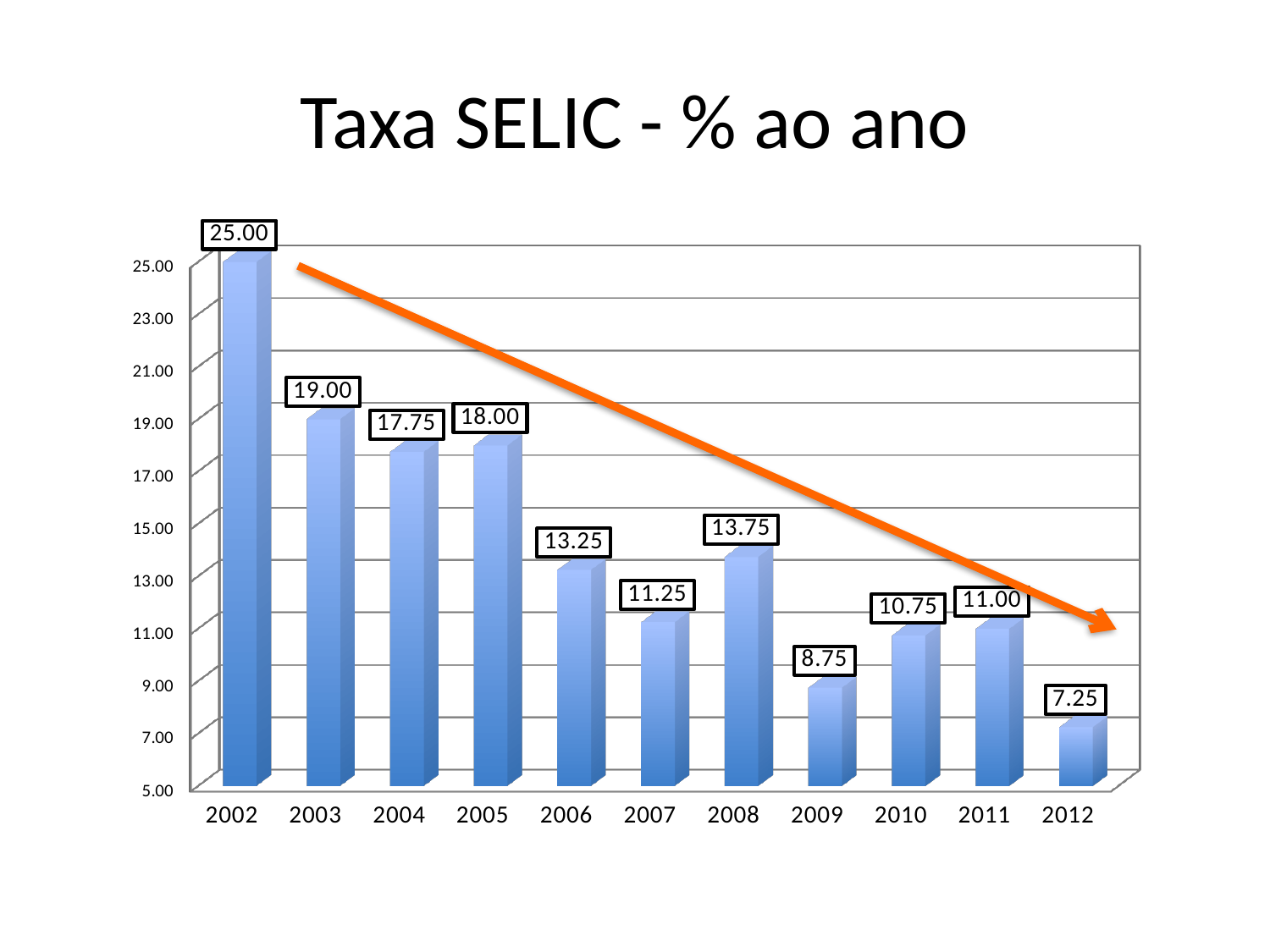
Do the values generally rise or fall from 2002 to 2012? fall What is the difference between the values for 2002 and 2012? 17.75 Which year has the highest value? 2002 What is the title of the chart? Taxa SELIC - % ao ano What is the value for 2008? 13.75 What is the value for 2012? 7.25 What is the value for 2002? 25.00 How many years are shown on the x axis? 11 What kind of chart is this? bar chart Which year has the lowest value? 2012 What is the difference between the values for 2004 and 2005? 0.25 Which is larger, the value for 2006 or the value for 2008? 2008